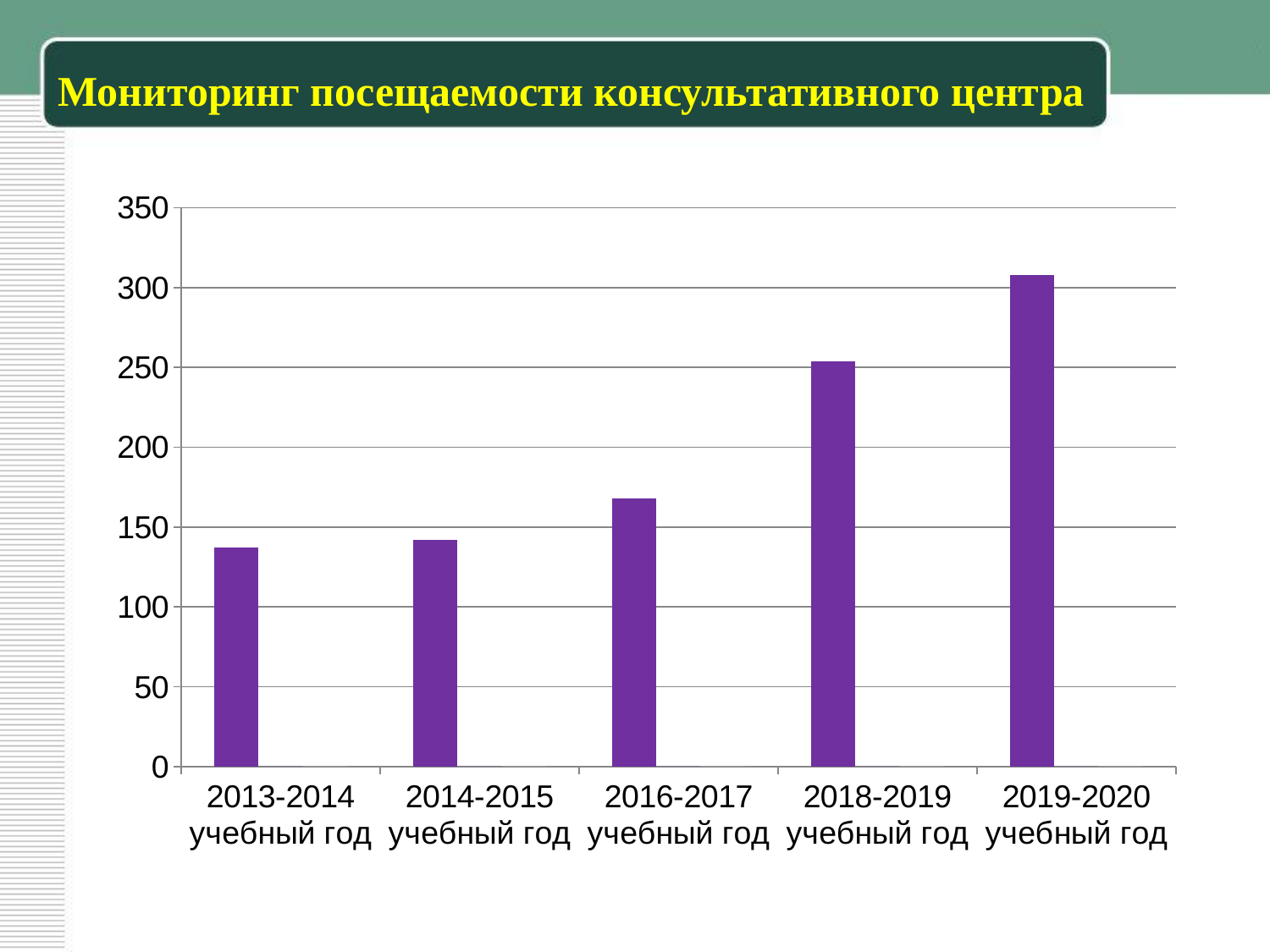
Which academic year has the highest value? 2019-2020 учебный год How many academic years (categories) are shown on the x axis? 5 Do the values rise or fall from 2013-2014 to 2019-2020 along the x axis? rise Is the value for 2019-2020 учебный год greater or less than 250? greater Is the value for 2014-2015 учебный год greater or less than 150? less What kind of chart is shown on the slide? bar chart Which is larger, the value for 2016-2017 учебный год or 2018-2019 учебный год? 2018-2019 учебный год Is the value for 2016-2017 учебный год greater or less than 150? greater What is the title of the slide containing the chart? Мониторинг посещаемости консультативного центра What is the maximum value shown on the vertical axis? 350